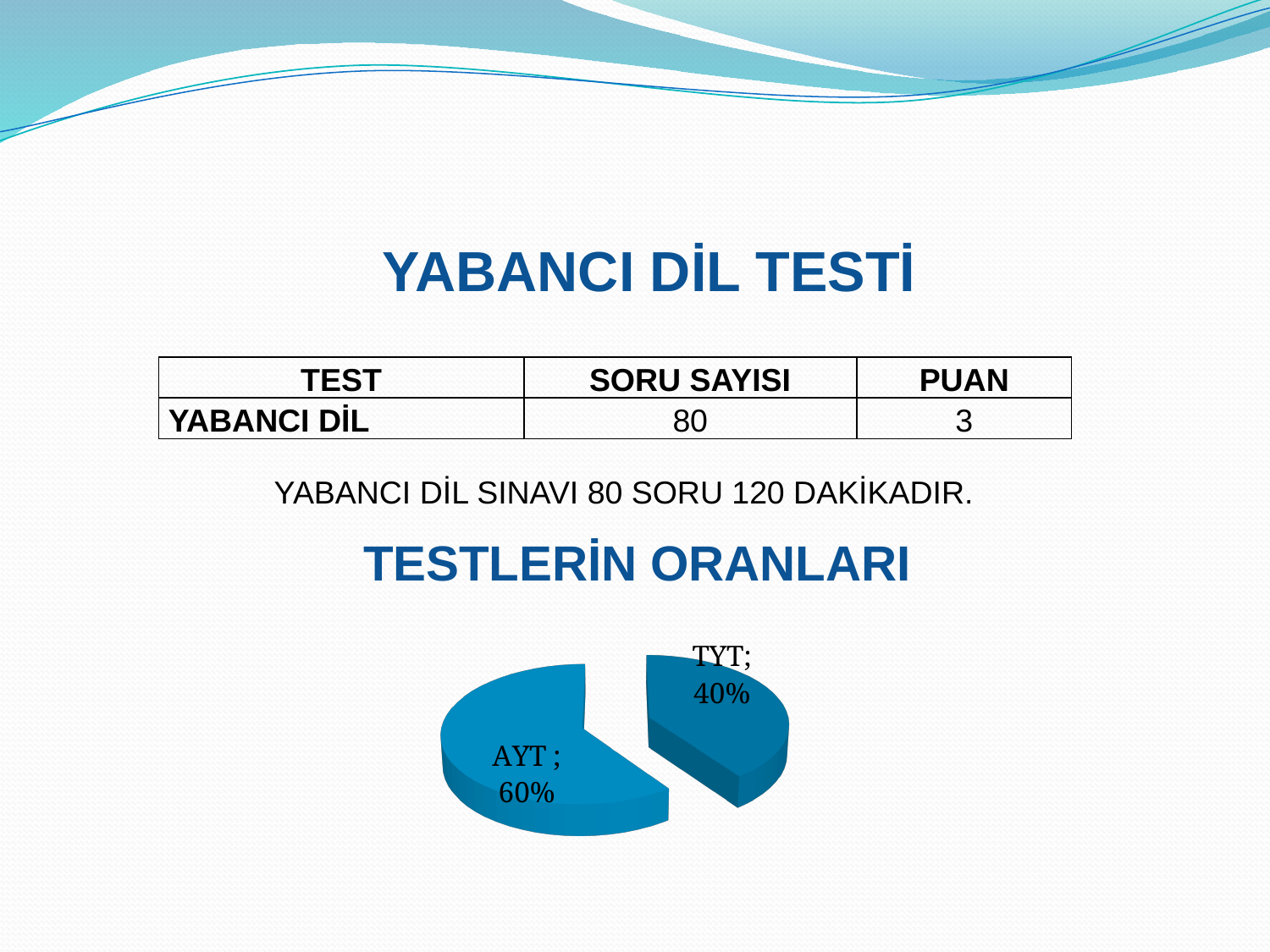
Which is larger in the pie chart, AYT or TYT? AYT What share of the pie chart does AYT have? 60% What kind of chart is shown under the heading TESTLERİN ORANLARI? pie chart Is the pie chart drawn with a 3-D effect? yes What heading appears directly above the pie chart? TESTLERİN ORANLARI Which slice of the pie chart is the largest? AYT What is the difference in percentage points between the AYT and TYT slices? 20% Which slice of the pie chart is the smallest? TYT How many slices does the pie chart have? 2 What share of the pie chart does TYT have? 40% What is the total of the two slices shown in the pie chart? 100%